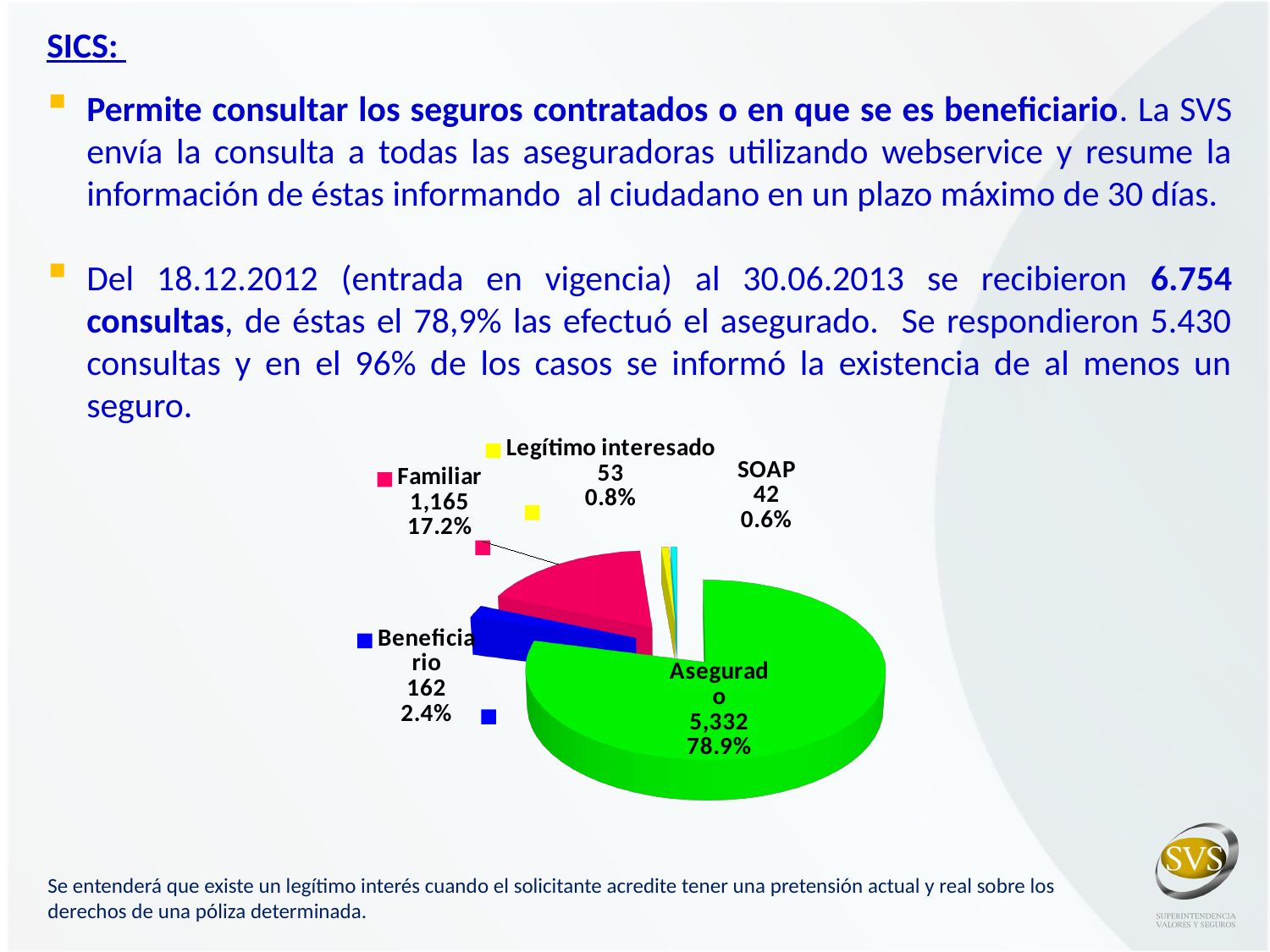
What is the value shown for Beneficiario? 162 What percentage is shown for Legítimo interesado? 0.8% What kind of chart is shown on the slide? pie chart What colour is the Asegurado slice in the pie chart? green What is the value shown for SOAP? 42 How many slices does the pie chart have? 5 What percentage share does the Familiar slice have? 17.2% What is the value shown for Asegurado in the pie chart? 5,332 Which category has the largest slice of the pie? Asegurado What is the difference between the values for Asegurado and Familiar? 4,167 Which category has the smallest slice of the pie? SOAP Which is larger, the value for Beneficiario or the value for Legítimo interesado? Beneficiario